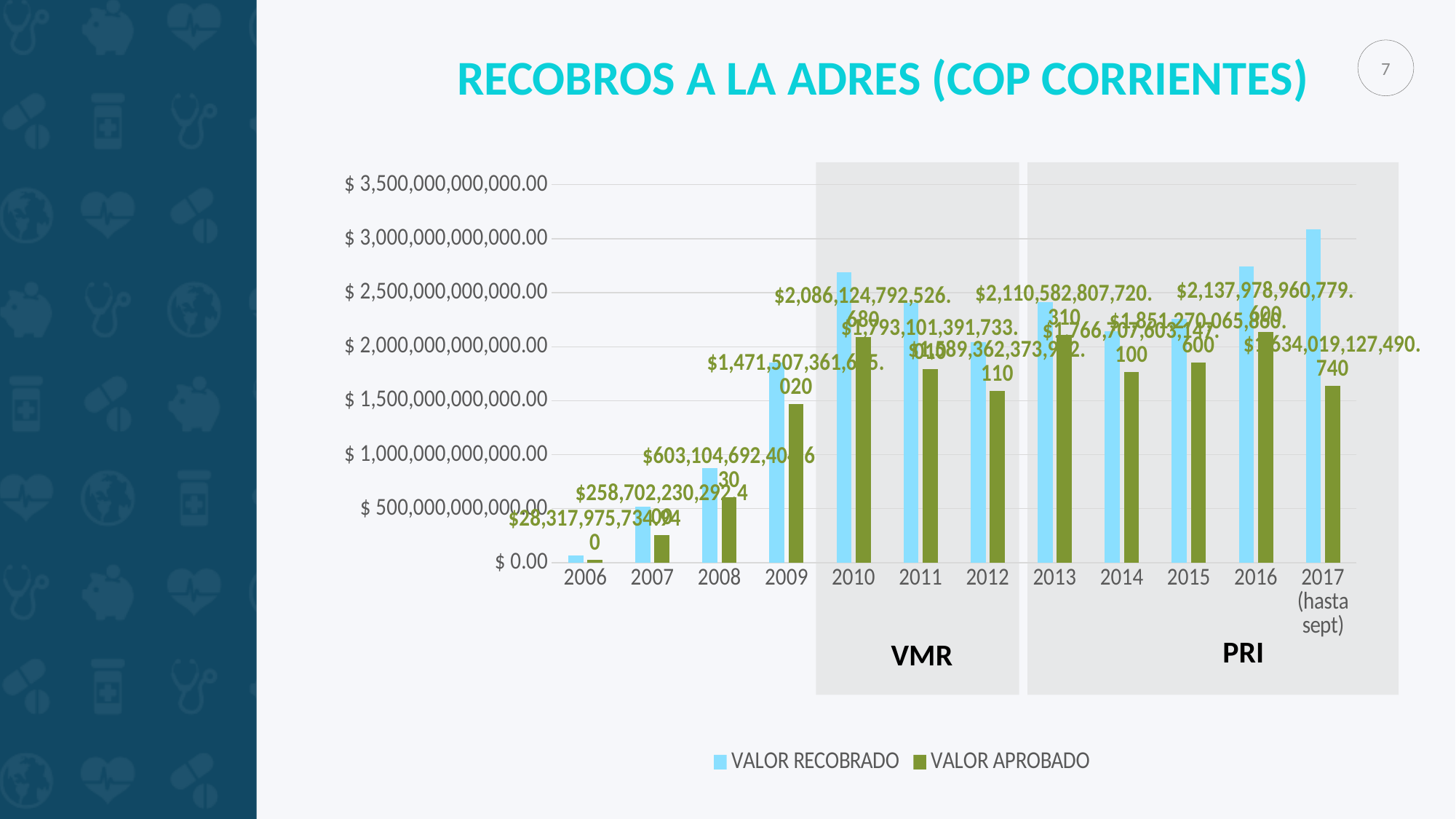
Is the VALOR RECOBRADO for 2010 greater or less than $2,500,000,000,000.00? greater Is the VALOR RECOBRADO for 2008 greater or less than $1,000,000,000,000.00? less In 2017 (hasta sept), which is larger: VALOR RECOBRADO or VALOR APROBADO? VALOR RECOBRADO Which year has the highest VALOR RECOBRADO? 2017 (hasta sept) How many series does the legend list? 2 What is the VALOR APROBADO for 2013? $2,110,582,807,720.310 Does the VALOR RECOBRADO rise or fall from 2006 to 2010? Rise Which year has the lowest VALOR RECOBRADO? 2006 What is the VALOR APROBADO for 2017 (hasta sept)? $1,634,019,127,490.740 What type of chart is shown on the slide? Bar chart Which years are grouped under the label VMR? 2010, 2011 and 2012 How many years (categories) are shown on the x axis? 12